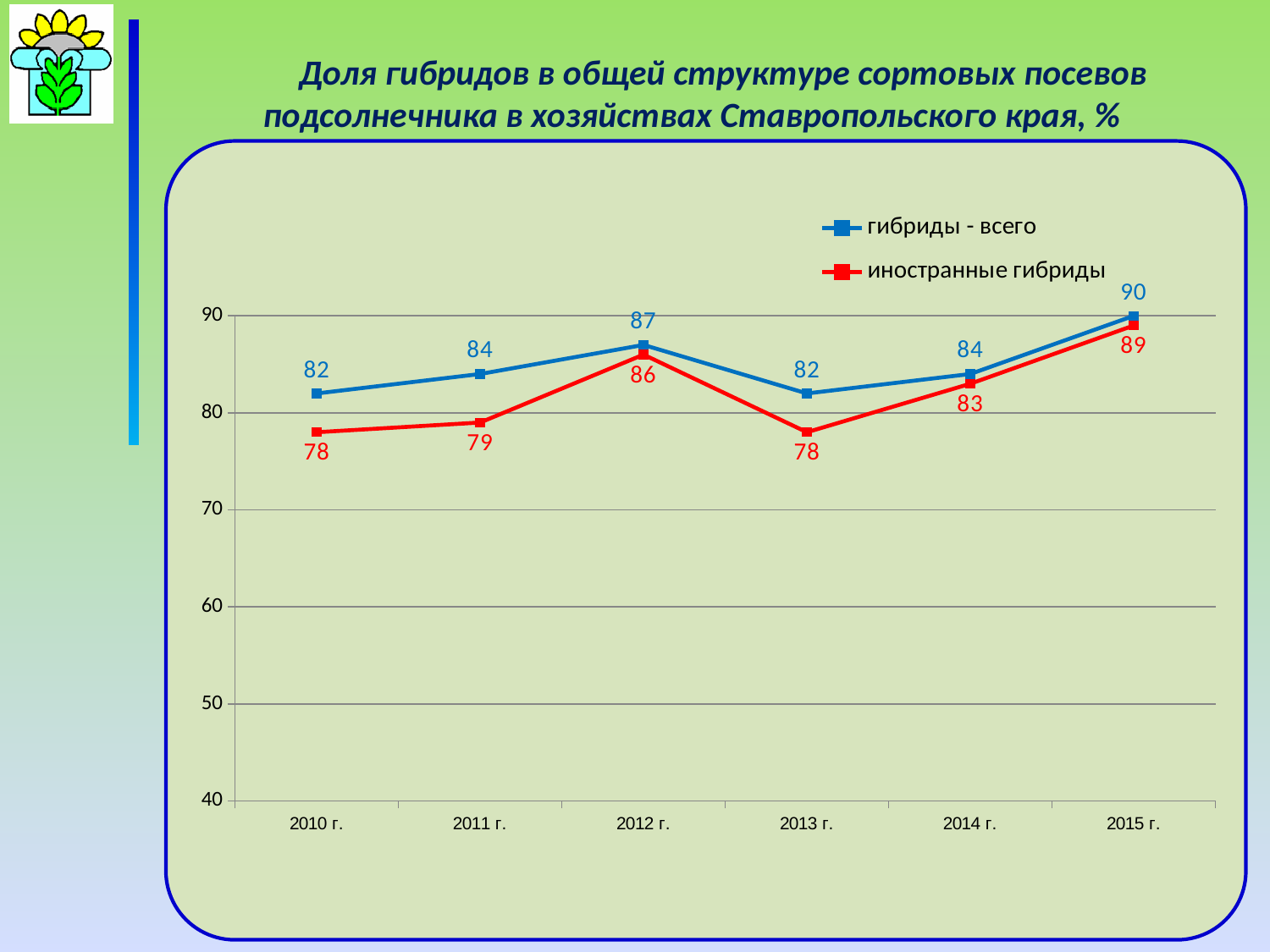
What is the difference between 'гибриды - всего' and 'иностранные гибриды' in 2011 г.? 5 How many series does the legend list? 2 In which year is 'иностранные гибриды' lowest? 2010 г. and 2013 г. How many years are shown on the x axis? 6 What colour is the line for 'иностранные гибриды'? red Does 'гибриды - всего' rise or fall from 2013 г. to 2015 г.? rise What is the value for 'гибриды - всего' in 2012 г.? 87 In which year is 'гибриды - всего' highest? 2015 г. Which is larger: 'иностранные гибриды' in 2012 г. or in 2015 г.? 2015 г. What is the value for 'иностранные гибриды' in 2010 г.? 78 What kind of chart is shown? line chart What is the value for 'иностранные гибриды' in 2014 г.? 83